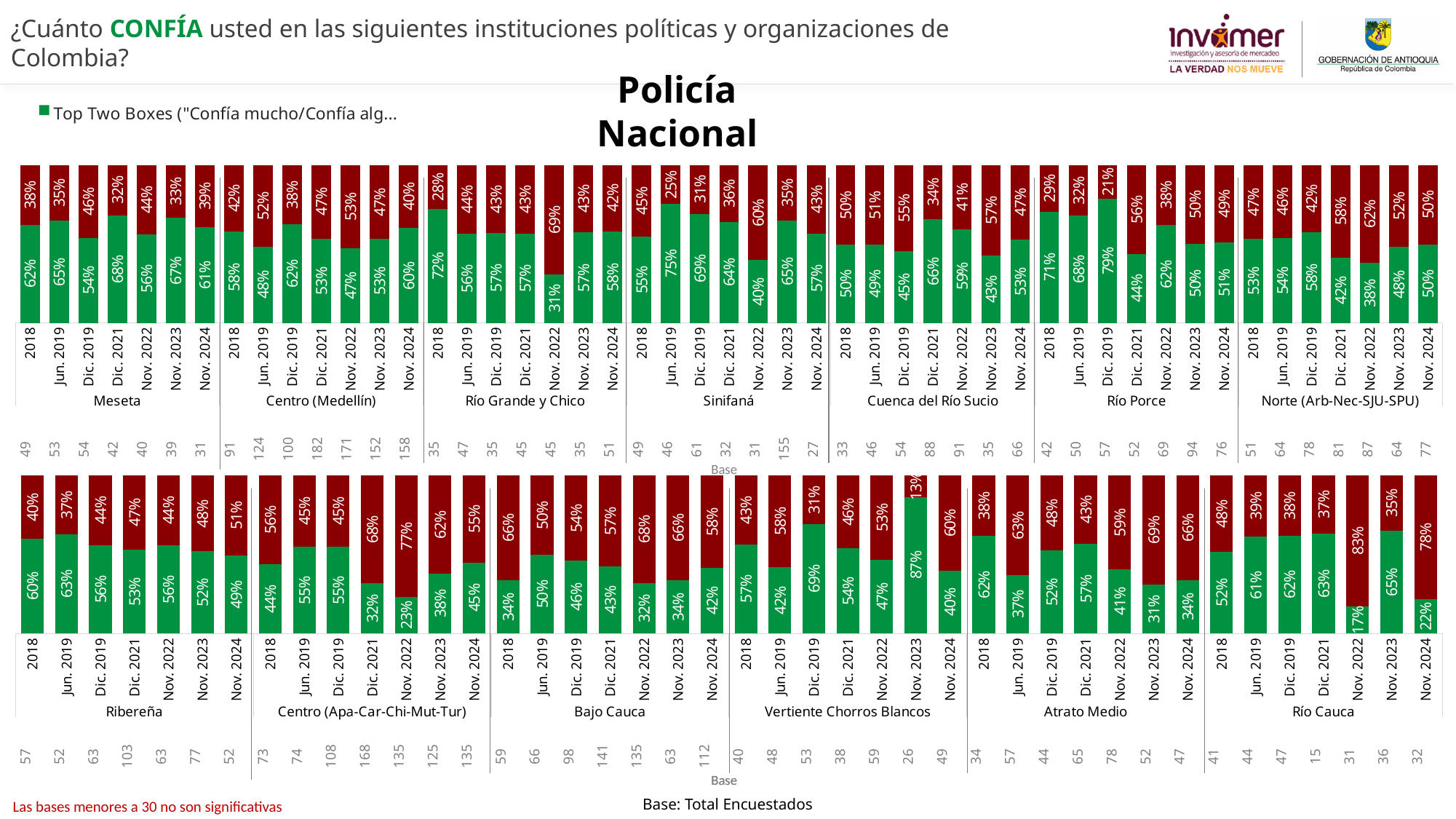
In the top chart, which period has the lowest green Top Two Boxes value for Río Grande y Chico? Nov. 2022 In the top chart, what is the difference between the green Top Two Boxes values for Meseta in 2018 and Nov. 2024? 1 percentage point In the bottom chart, which is larger: the green Top Two Boxes value for Atrato Medio in 2018 or in Nov. 2023? 2018 In the bottom chart, what is the green Top Two Boxes value for Vertiente Chorros Blancos in Nov. 2023? 87% In the bottom chart, what is the red segment value for Río Cauca in Nov. 2022? 83% In the bottom chart, which period has the lowest green Top Two Boxes value for Centro (Apa-Car-Chi-Mut-Tur)? Nov. 2022 What kind of chart is used on this slide? Stacked bar chart In the top chart, what is the green Top Two Boxes value for Meseta in Dic. 2021? 68% In the bottom chart, how many periods are shown for Bajo Cauca? 7 In the top chart, what is the green Top Two Boxes value for Río Porce in Dic. 2019? 79% In the top chart, which period has the highest green Top Two Boxes value for Sinifaná? Jun. 2019 In the top chart, what is the total of the green and red segments for Norte (Arb-Nec-SJU-SPU) in Nov. 2024? 100%